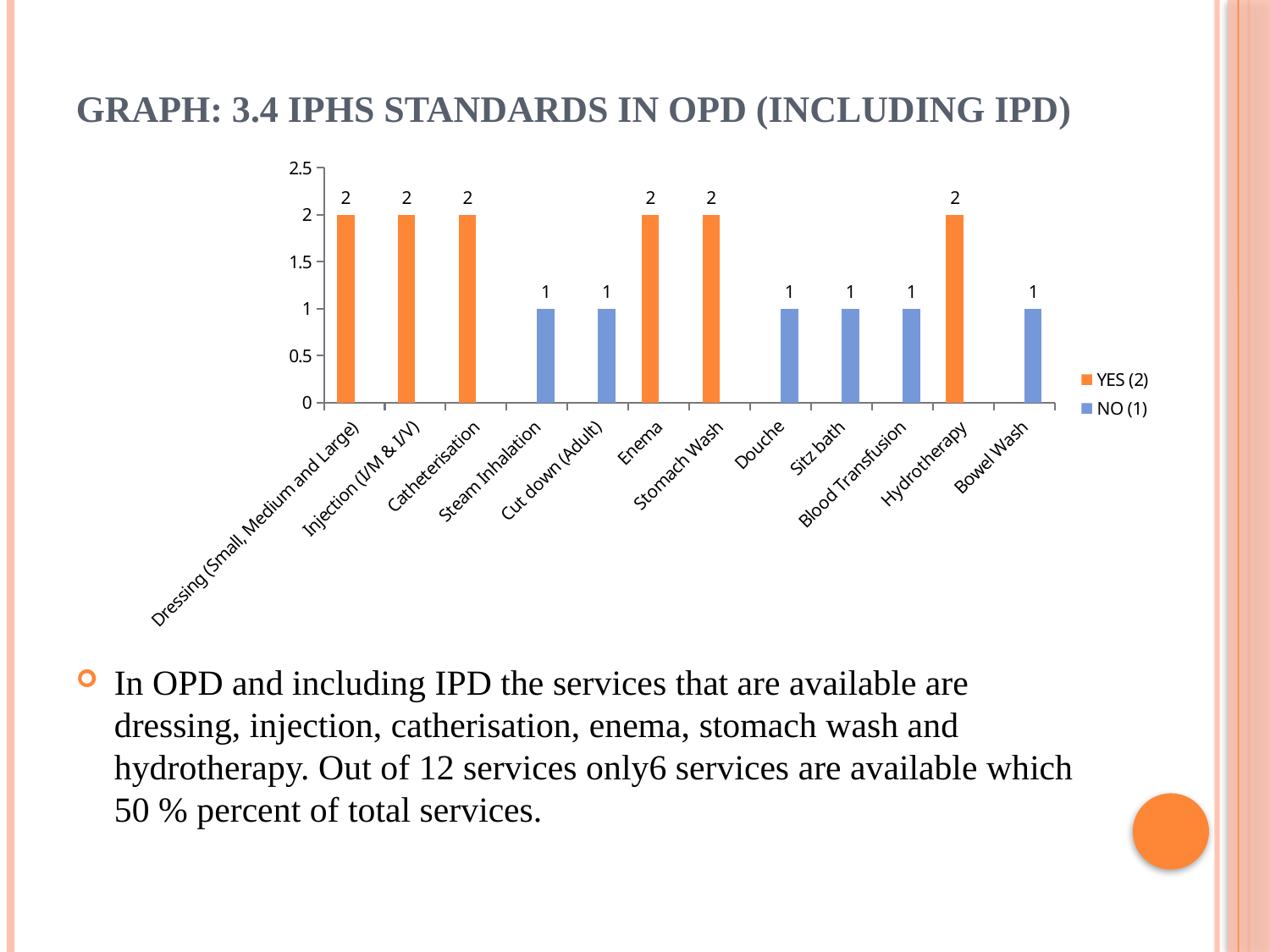
How many categories have a value of 2? 6 How many series does the legend list? 2 What is the value for Enema? 2 What is the difference between the values for Catheterisation and Douche? 1 Which series is shown in orange according to the legend? YES (2) What kind of chart is shown on the slide? Bar chart Which series does the Blood Transfusion bar belong to? NO (1) How many categories are shown on the x axis? 12 Which is larger, the value for Stomach Wash or the value for Sitz bath? Stomach Wash What is the value for Steam Inhalation? 1 What is the value for Bowel Wash? 1 What is the value for Hydrotherapy? 2